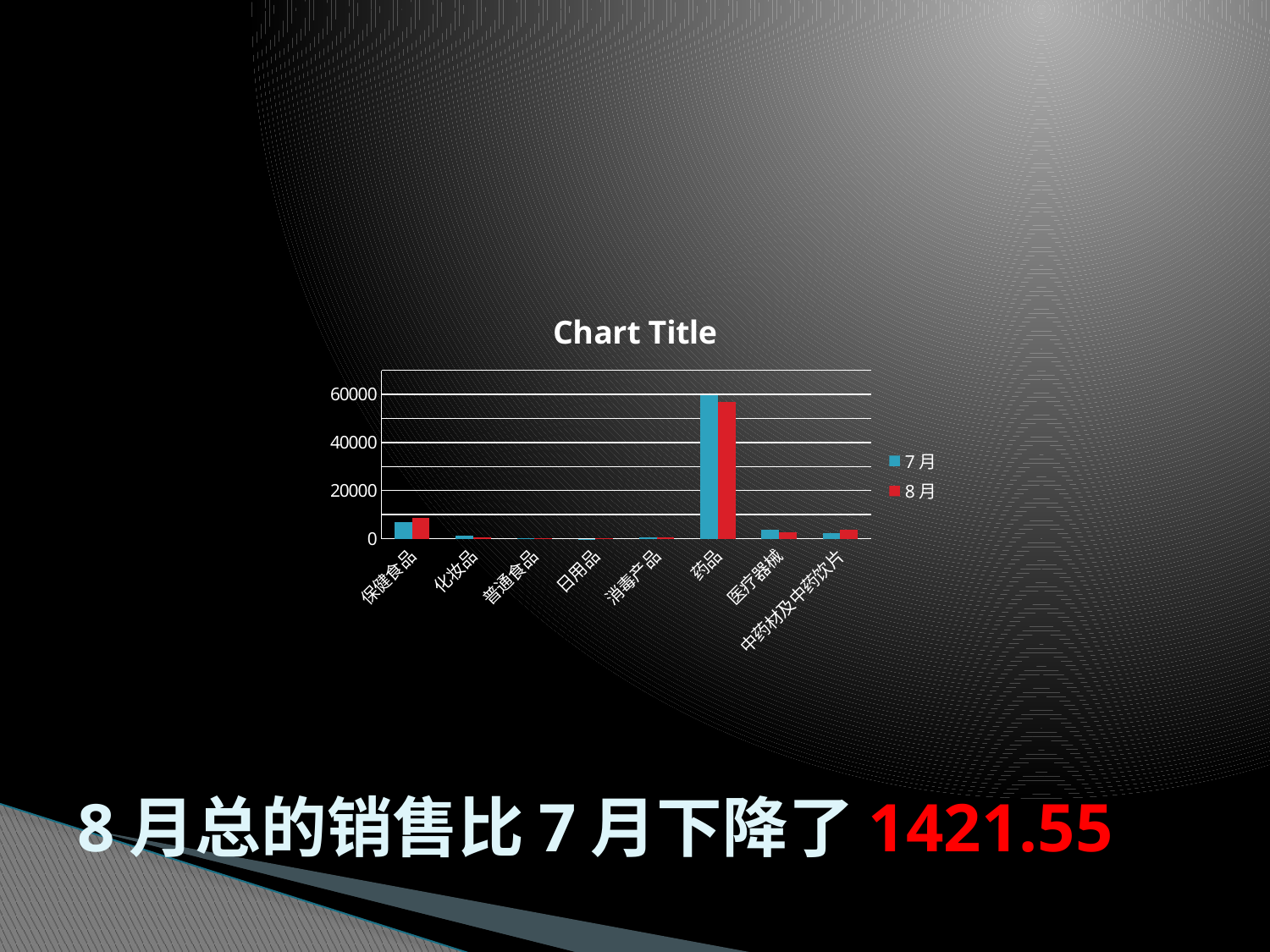
Is the 7月 value for 药品 greater or less than 40000? greater What kind of chart is shown on the slide? bar chart For 药品, which series has the larger value, 7月 or 8月? 7月 How many series does the legend list? 2 Is the 7月 value for 保健食品 greater or less than 20000? less How many categories are shown on the x axis? 8 What are the two series named in the legend? 7月 and 8月 What is the title of the chart? Chart Title Which category has the highest value for 8月? 药品 Is the 8月 value for 药品 greater or less than 40000? greater Which category has the highest value for 7月? 药品 For 保健食品, which series has the larger value, 7月 or 8月? 8月